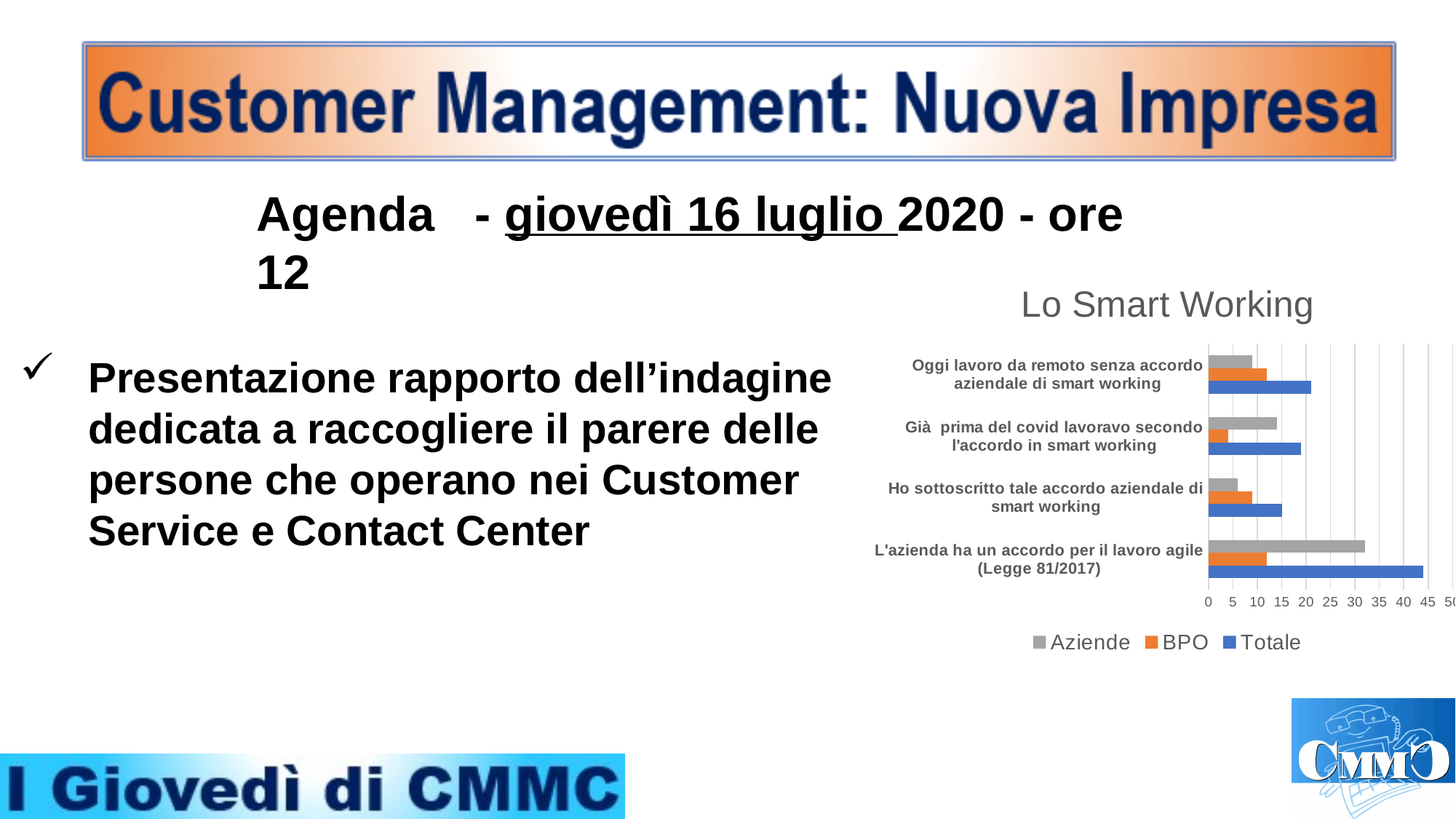
For "Già prima del covid lavoravo secondo l'accordo in smart working", which is larger: the Aziende value or the BPO value? Aziende Which series in the "Lo Smart Working" chart is shown in orange? BPO Which category has the lowest Totale value in the "Lo Smart Working" chart? Ho sottoscritto tale accordo aziendale di smart working Which category has the highest Totale value in the "Lo Smart Working" chart? L'azienda ha un accordo per il lavoro agile (Legge 81/2017) Is the Totale value for "L'azienda ha un accordo per il lavoro agile (Legge 81/2017)" greater or less than 40? greater What kind of chart is shown under the title "Lo Smart Working"? bar chart Is the Aziende value for "L'azienda ha un accordo per il lavoro agile (Legge 81/2017)" greater or less than 25? greater Is the BPO value for "Già prima del covid lavoravo secondo l'accordo in smart working" greater or less than 10? less How many series does the legend of the "Lo Smart Working" chart list? 3 Which category has the lowest BPO value in the "Lo Smart Working" chart? Già prima del covid lavoravo secondo l'accordo in smart working How many categories are plotted in the "Lo Smart Working" chart? 4